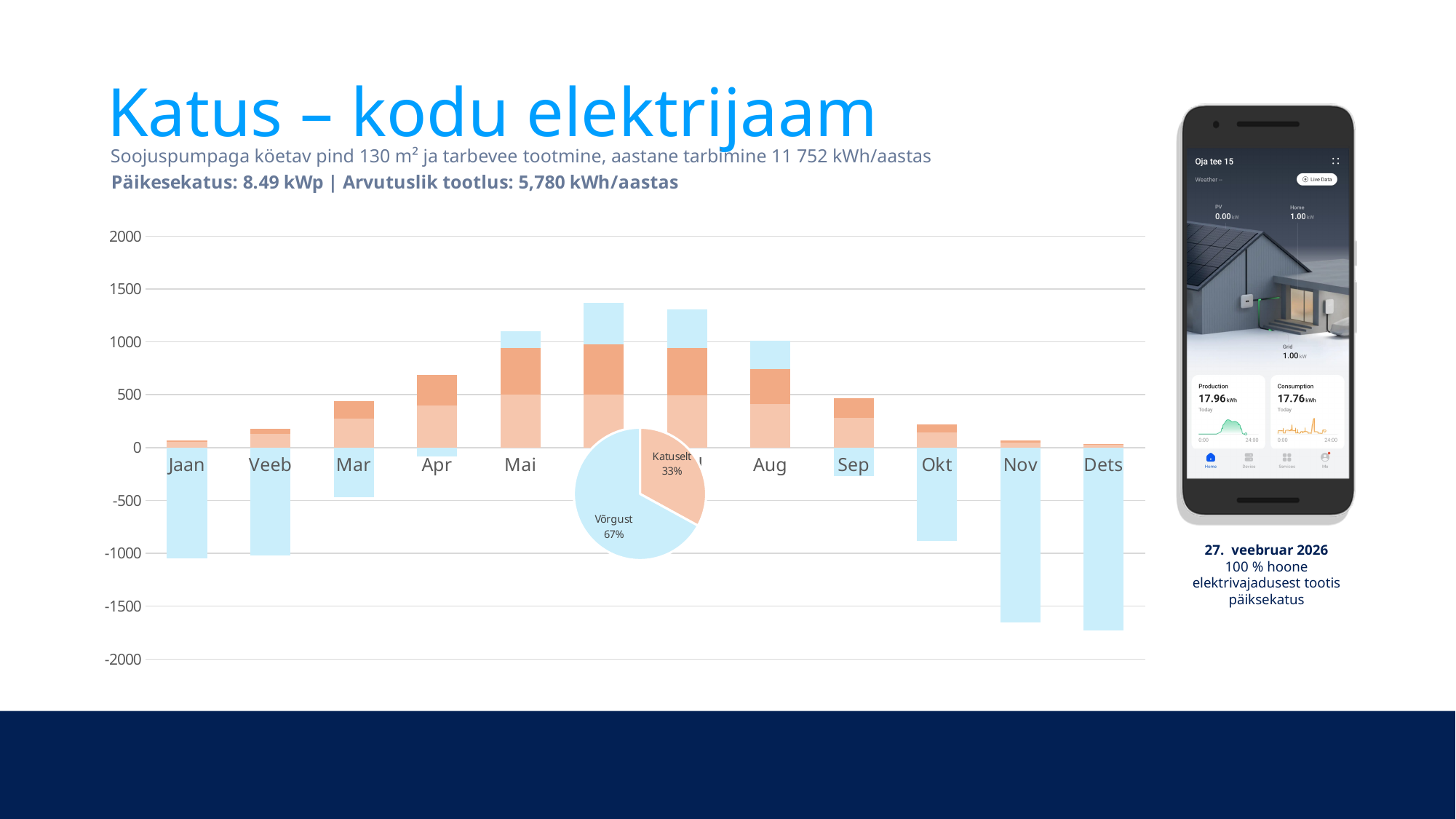
In the bar chart, is the bottom of the negative bar for Mar greater or less than -1000? greater Which slice of the pie chart is larger, Katuselt or Võrgust? Võrgust In the bar chart, do the positive bars rise or fall from Jaan to Mai? rise In the pie chart, what share is labelled Katuselt? 33% How many months (categories) are shown on the x axis of the bar chart? 12 In the bar chart, is the top of the positive bar for Mai greater or less than 1500? less In the pie chart, what share is labelled Võrgust? 67% In the bar chart, is the bottom of the negative bar for Dets greater or less than -1500? less How many slices does the pie chart have? 2 What kind of chart is the large chart with the months Jaan to Dets? bar chart